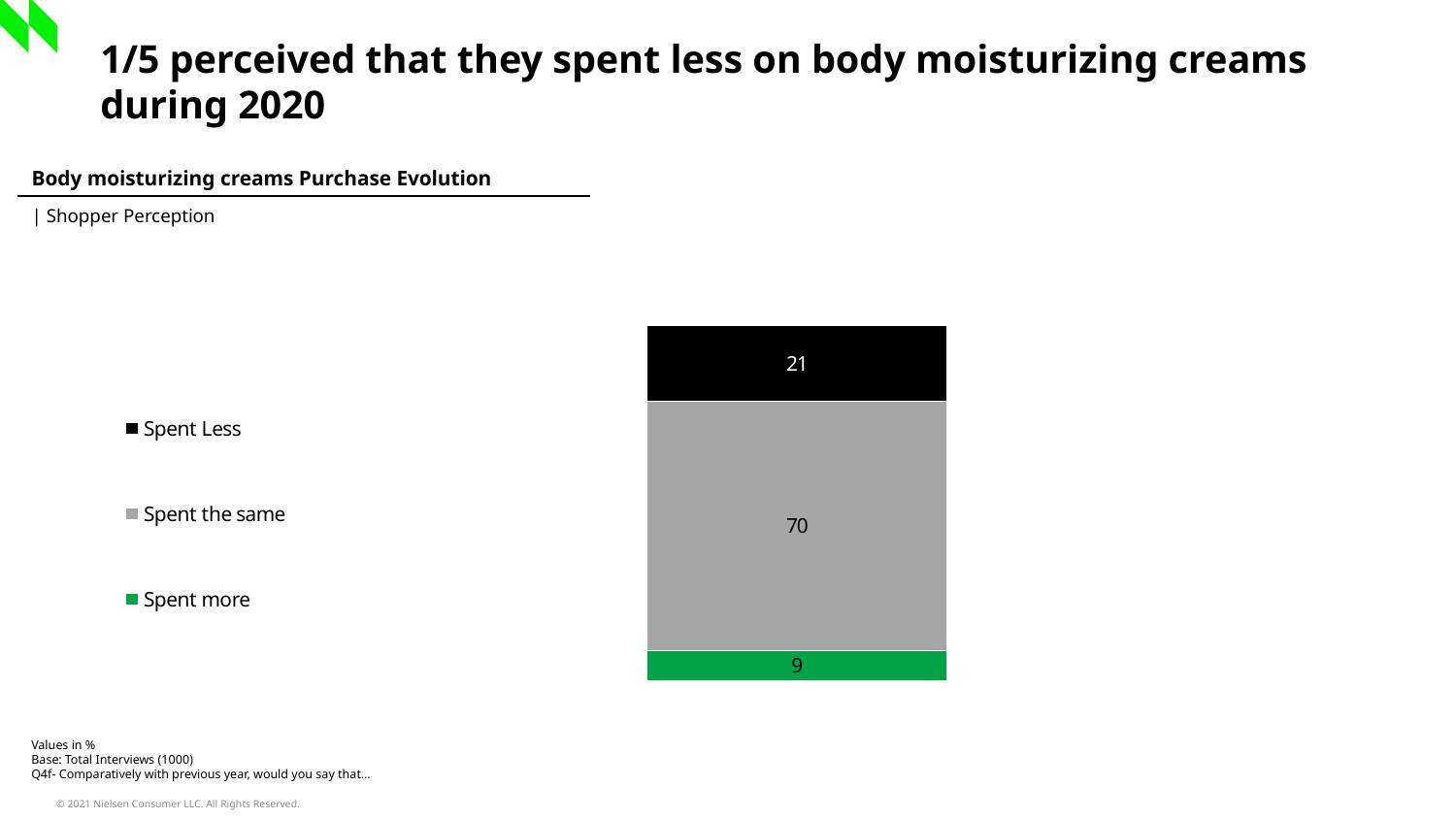
Which segment of the stacked bar has the lowest value? Spent more Which colour represents 'Spent more' in the legend? Green How many series does the legend list? 3 Which segment of the stacked bar has the highest value? Spent the same What is the difference between the 'Spent the same' value and the 'Spent Less' value? 49 What value is shown for the 'Spent Less' segment of the stacked bar? 21 What is the total of the three segments in the stacked bar? 100 What is the difference between the 'Spent Less' value and the 'Spent more' value? 12 What kind of chart is shown on the slide? Stacked bar chart Which is larger, the value for 'Spent Less' or the value for 'Spent more'? Spent Less What value is shown for the 'Spent more' segment of the stacked bar? 9 What value is shown for the 'Spent the same' segment of the stacked bar? 70